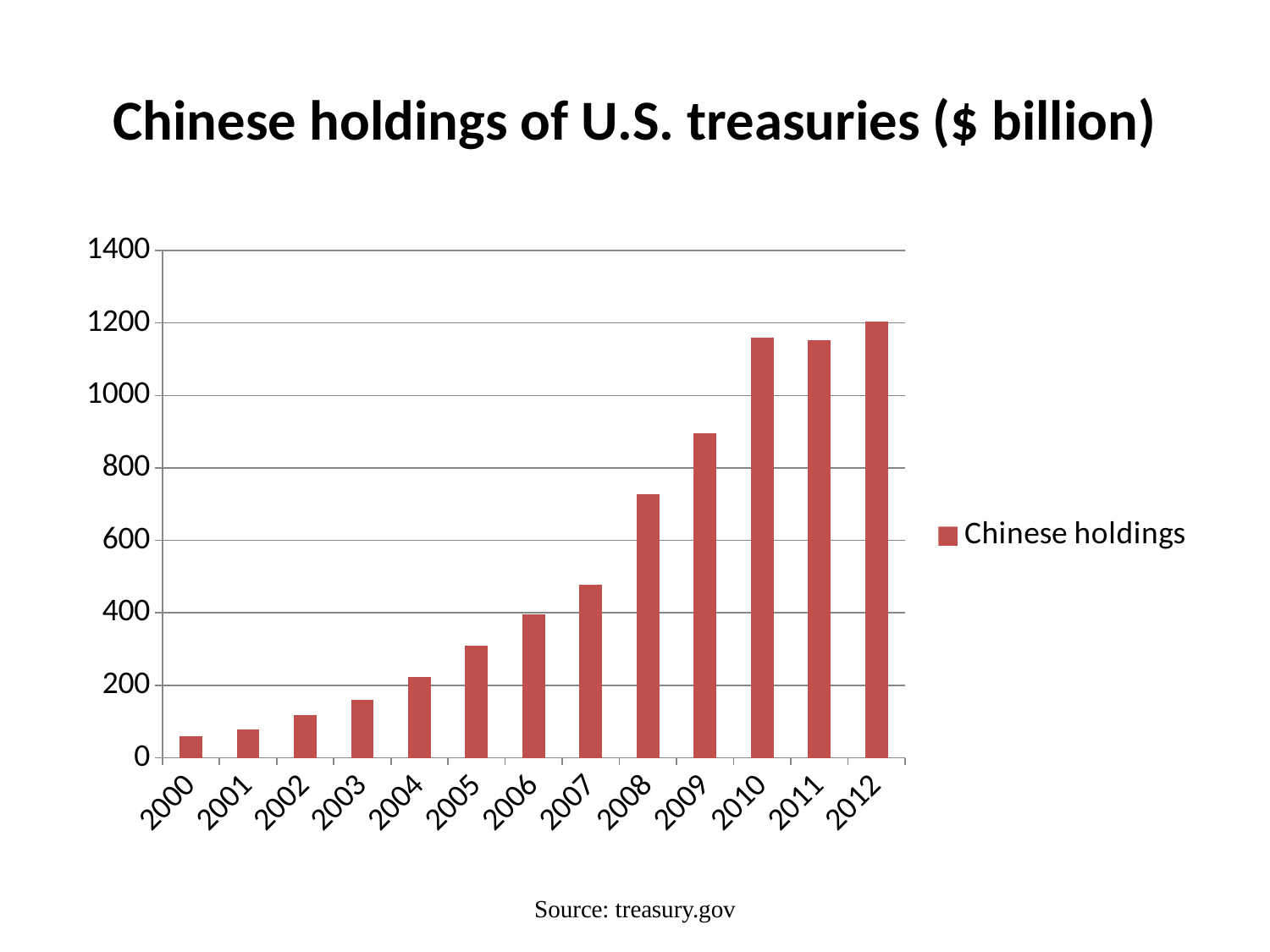
Is the value for 2009 greater or less than 800? greater Is the value for 2008 greater or less than 800? less How many years are shown on the x axis of the chart? 13 How many series does the legend list? 1 What is the name of the series listed in the legend? Chinese holdings Do Chinese holdings of U.S. treasuries generally rise or fall from 2000 to 2012? rise What kind of chart is shown on the slide? bar chart Which year has larger Chinese holdings, 2008 or 2009? 2009 Is the value for 2010 greater or less than 1000? greater Which year has the highest Chinese holdings of U.S. treasuries? 2012 Which year has the lowest Chinese holdings of U.S. treasuries? 2000